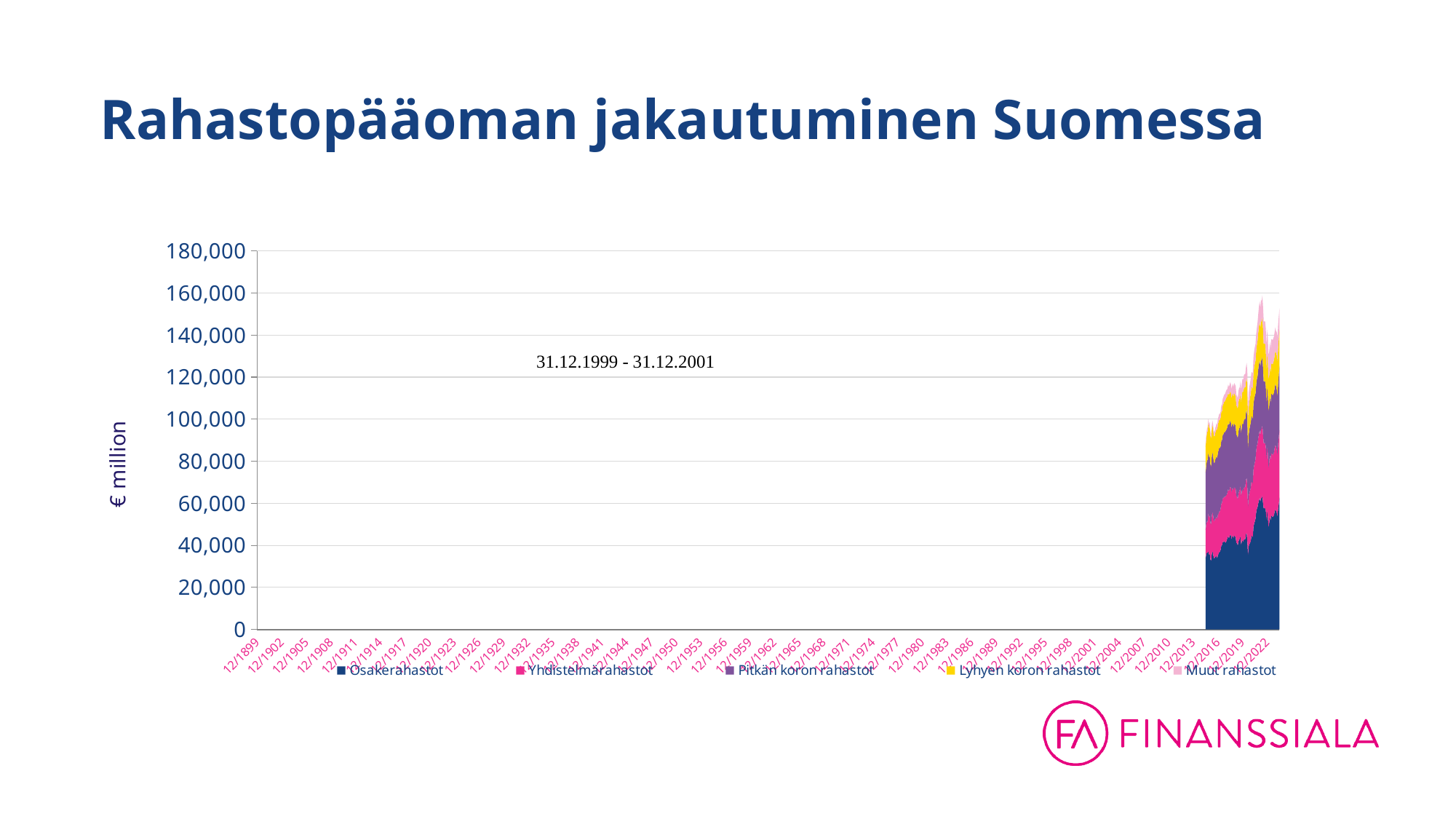
Which series has the largest value at the end of the chart? Osakerahastot Is the total of all series at 12/2016 greater or less than 120,000? less What is the title of the chart? Rahastopääoman jakautuminen Suomessa What kind of chart is shown on the slide? Stacked area chart How many series does the legend list? 5 Does the total fund capital generally rise or fall from 12/2016 to 12/2022? rise What is the label on the vertical axis? € million Which series is larger at the end of the chart, Osakerahastot or Lyhyen koron rahastot? Osakerahastot Is the peak total of the stacked areas greater or less than 140,000? greater Is the peak total of the stacked areas greater or less than 180,000? less What is the highest tick value shown on the vertical axis? 180,000